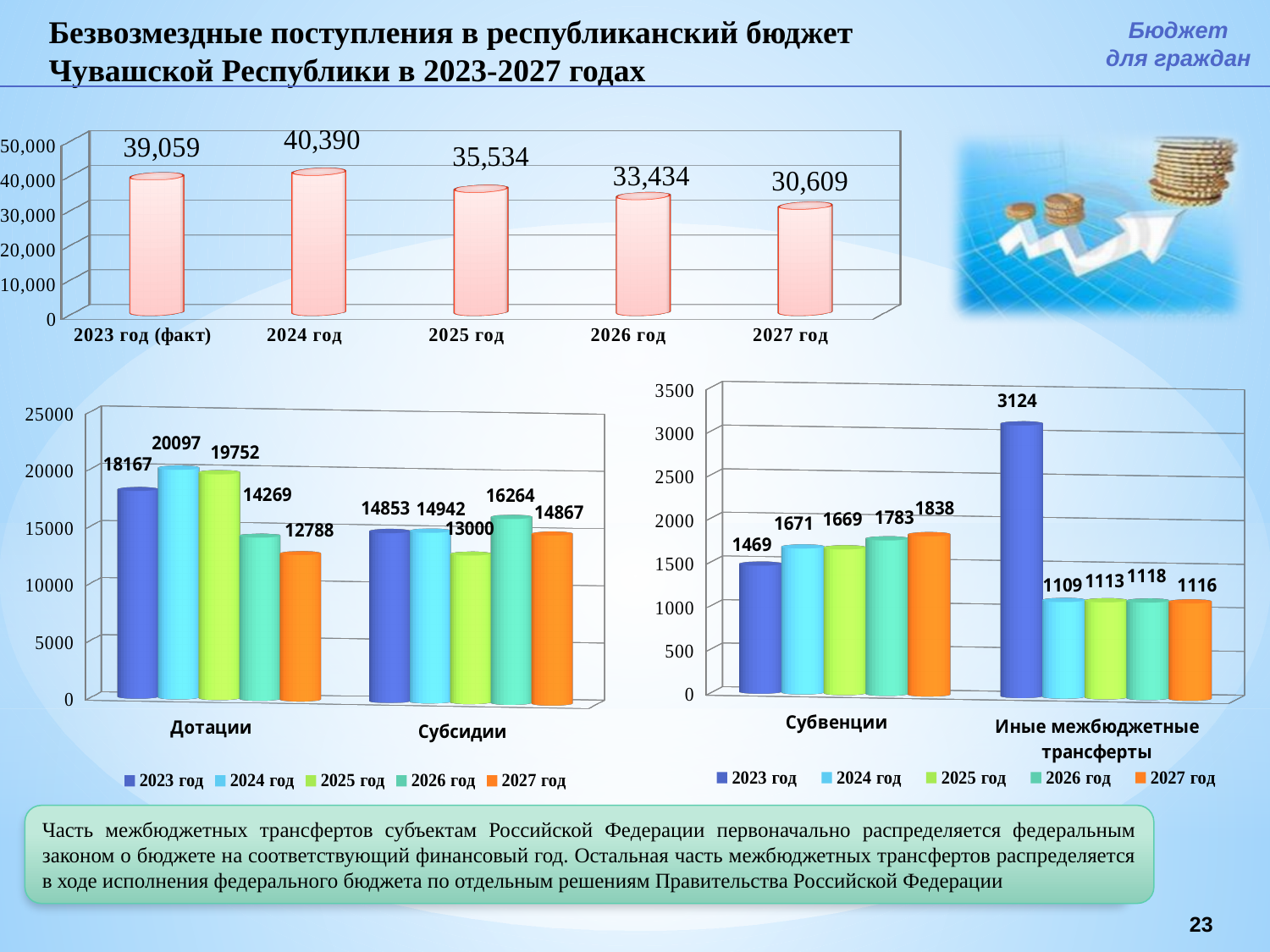
In the bottom-right chart, what is the difference between Субвенции in 2027 год and Субвенции in 2023 год? 369 In the top chart, what is the difference between the values for 2024 год and 2027 год? 9,781 In the top chart, what is the value for 2024 год? 40,390 In the top chart, do the values rise or fall from 2024 год to 2027 год? fall In the bottom-left chart, which year has the highest value for Субсидии? 2026 год In the bottom-left chart, which is larger: Дотации in 2027 год or Субсидии in 2027 год? Субсидии in 2027 год In the top chart, which year has the lowest value? 2027 год What type of chart is the bottom-right chart? bar chart In the bottom-right chart, what is the value for Иные межбюджетные трансферты in 2023 год? 3124 In the bottom-left chart, how many series does the legend list? 5 In the bottom-left chart, what is the value for Дотации in 2025 год? 19752 In the top chart, how many years are shown? 5